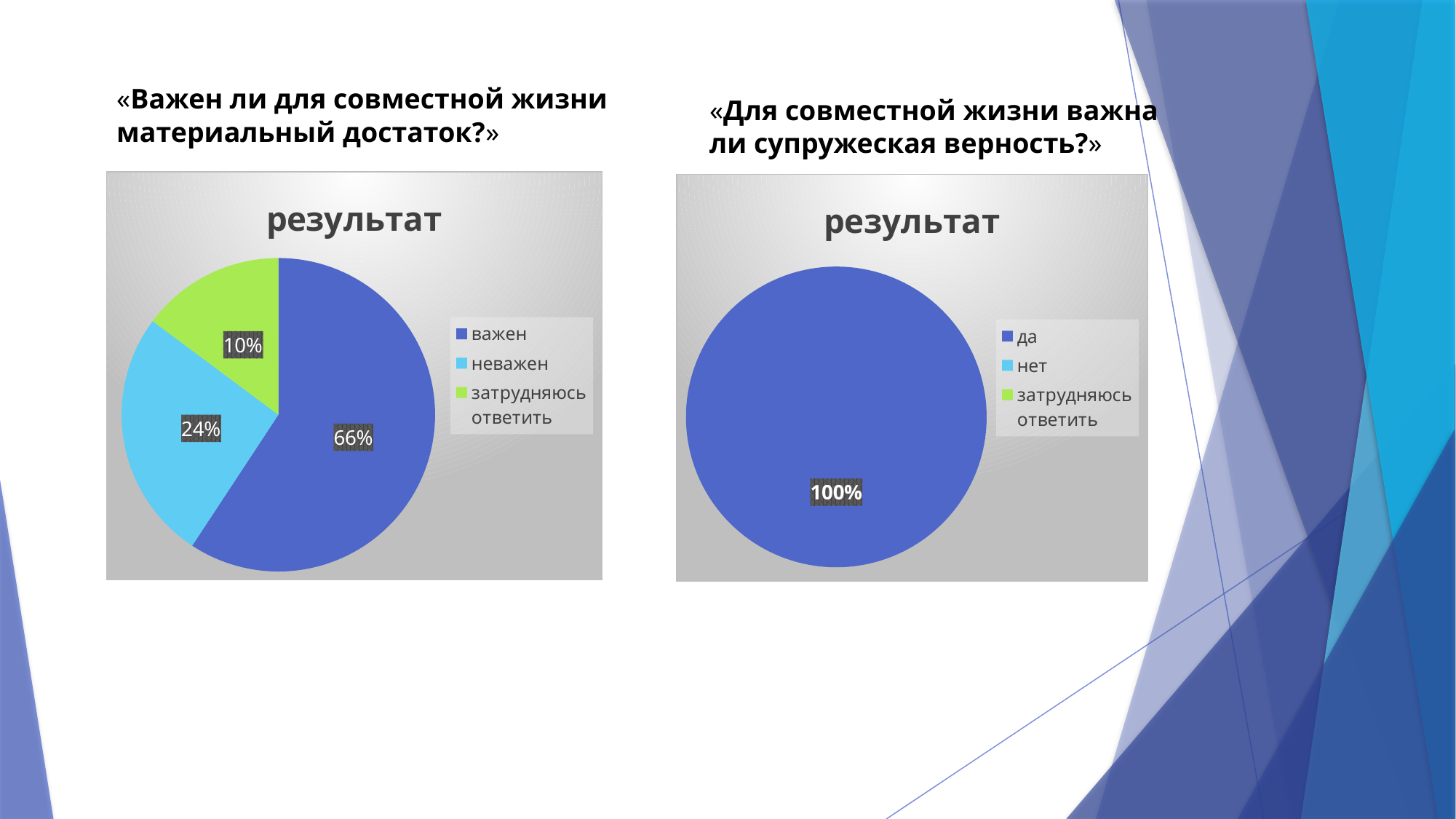
In the left pie chart (about материальный достаток), which answer has the largest share? важен In the right pie chart (about супружеская верность), what share of respondents answered «да»? 100% In the left pie chart (about материальный достаток), what share of respondents answered «важен»? 66% What type of chart is used on the right side of the slide (about супружеская верность)? pie chart In the left pie chart (about материальный достаток), which answer has the smallest share? затрудняюсь ответить In the left pie chart (about материальный достаток), what share of respondents answered «неважен»? 24% In the left pie chart (about материальный достаток), what is the difference in percentage points between «важен» and «неважен»? 42 In the left pie chart (about материальный достаток), what share of respondents answered «затрудняюсь ответить»? 10% What is the title shown inside the left chart (about материальный достаток)? результат How many entries does the legend of the right pie chart (about супружеская верность) list? 3 How many entries does the legend of the left pie chart (about материальный достаток) list? 3 In the left pie chart (about материальный достаток), which is larger: the share for «неважен» or for «затрудняюсь ответить»? неважен